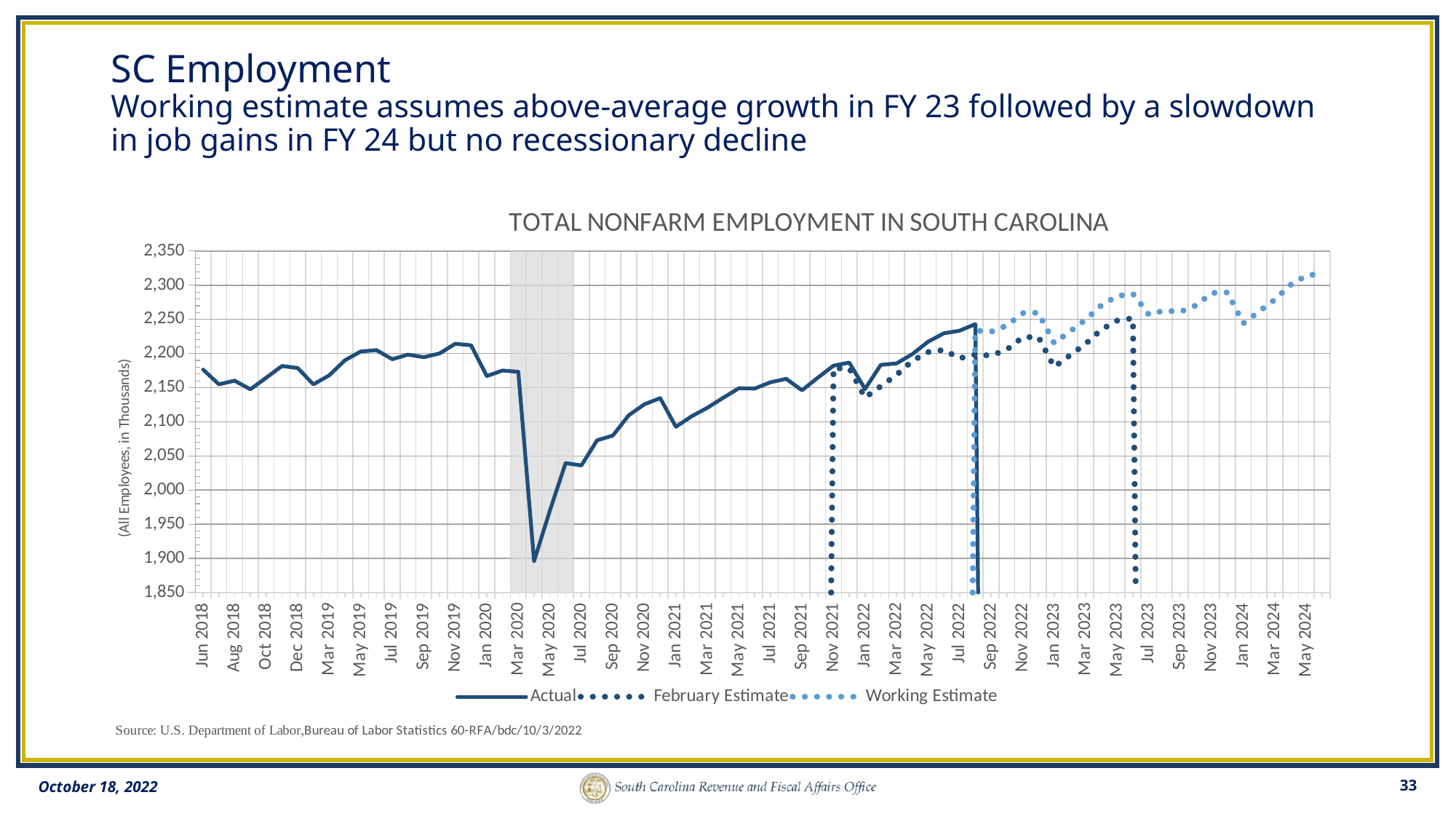
What kind of chart is shown on the slide? Line chart Is the Actual value for Jun 2018 greater or less than 2,150? greater Around which month does the Actual series reach its lowest value? Apr 2020 What is the title of the chart? TOTAL NONFARM EMPLOYMENT IN SOUTH CAROLINA Is the lowest point of the Actual series, in spring 2020, greater or less than 1,950? less Is the February Estimate value for Jan 2023 greater or less than 2,200? less Does the Actual series rise or fall from Jan 2021 to Jul 2022? Rise Does the Working Estimate rise or fall from Jan 2024 to May 2024? Rise How many series does the chart legend list? 3 At Jan 2023, which is higher: the Working Estimate or the February Estimate? Working Estimate Which series is drawn as a solid line rather than a dotted line? Actual